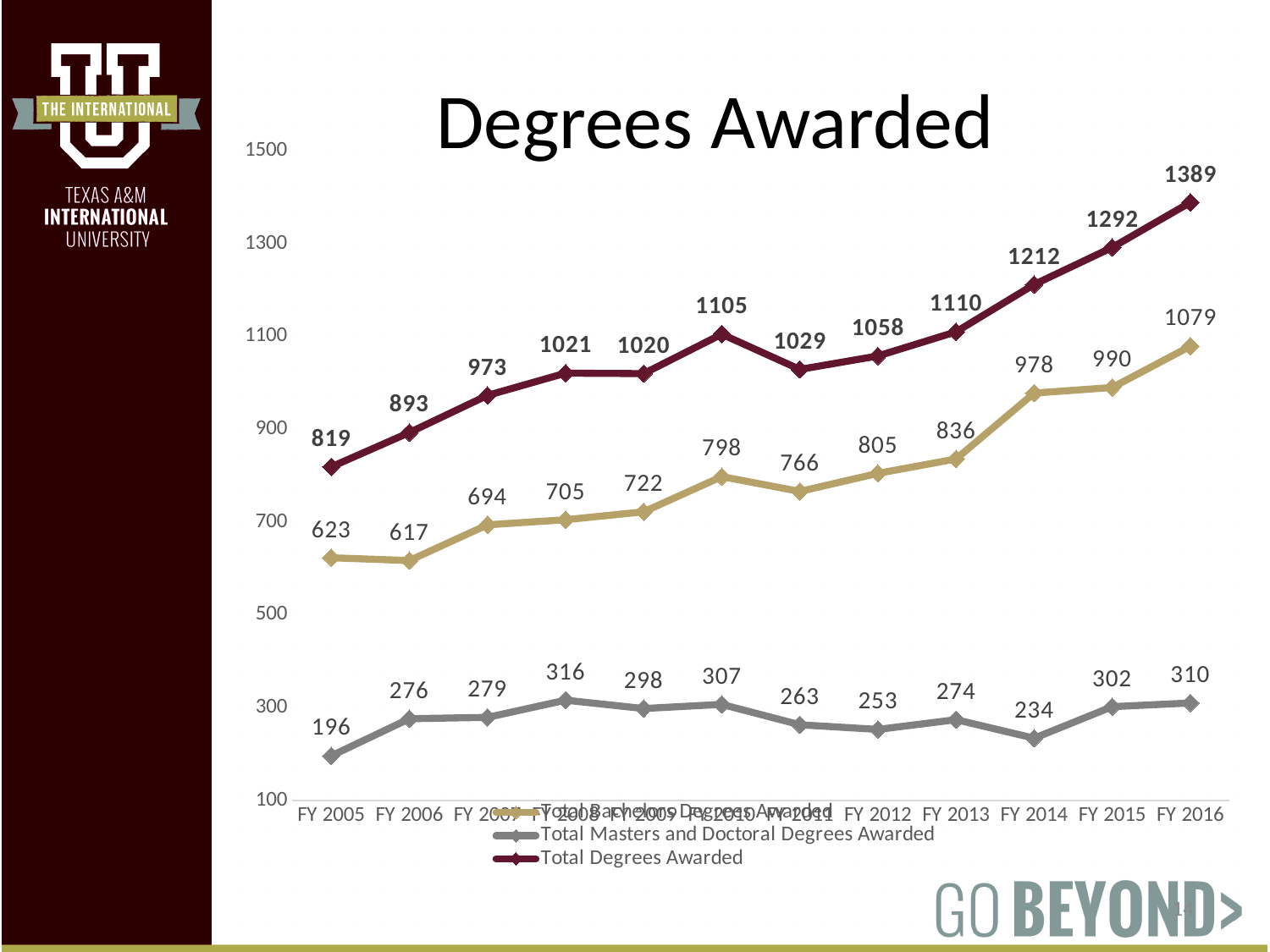
What is the value of Total Degrees Awarded in FY 2016? 1389 What is the difference between Total Degrees Awarded in FY 2016 and FY 2005? 570 What is the title of the chart? Degrees Awarded How many fiscal years are plotted along the x axis? 12 Does Total Degrees Awarded generally rise or fall from FY 2005 to FY 2016? rise Which is larger: Total Masters and Doctoral Degrees Awarded in FY 2010 or in FY 2014? FY 2010 What type of chart is shown on the slide? line chart How many series does the legend list? 3 What is the value of Total Bachelors Degrees Awarded in FY 2011? 766 What is the value of Total Masters and Doctoral Degrees Awarded in FY 2005? 196 In which fiscal year is Total Bachelors Degrees Awarded lowest? FY 2006 In which fiscal year is Total Masters and Doctoral Degrees Awarded highest? FY 2008